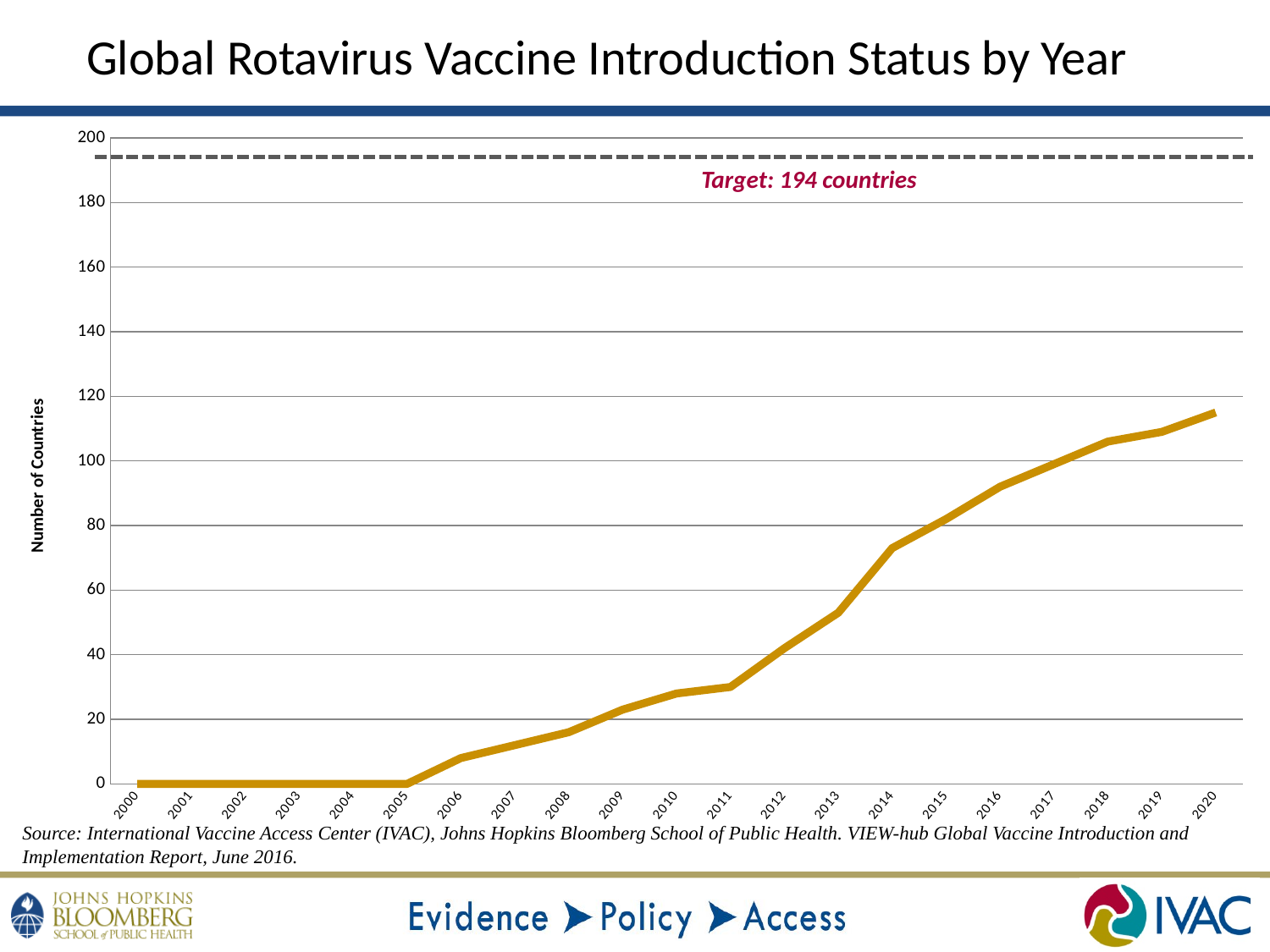
Do the values rise or fall from 2006 to 2020? rise Is the value for 2018 greater or less than 120? less What is the number of countries shown for 2003? 0 How many years are plotted along the x axis? 21 Is the value for 2014 greater or less than 60? greater What is the number of countries shown for 2005? 0 Is the value for 2010 greater or less than 40? less Which year has the larger value, 2012 or 2016? 2016 Which year has the highest number of countries? 2020 What kind of chart is shown on the slide? line chart What target is marked by the dashed line on the chart? 194 countries